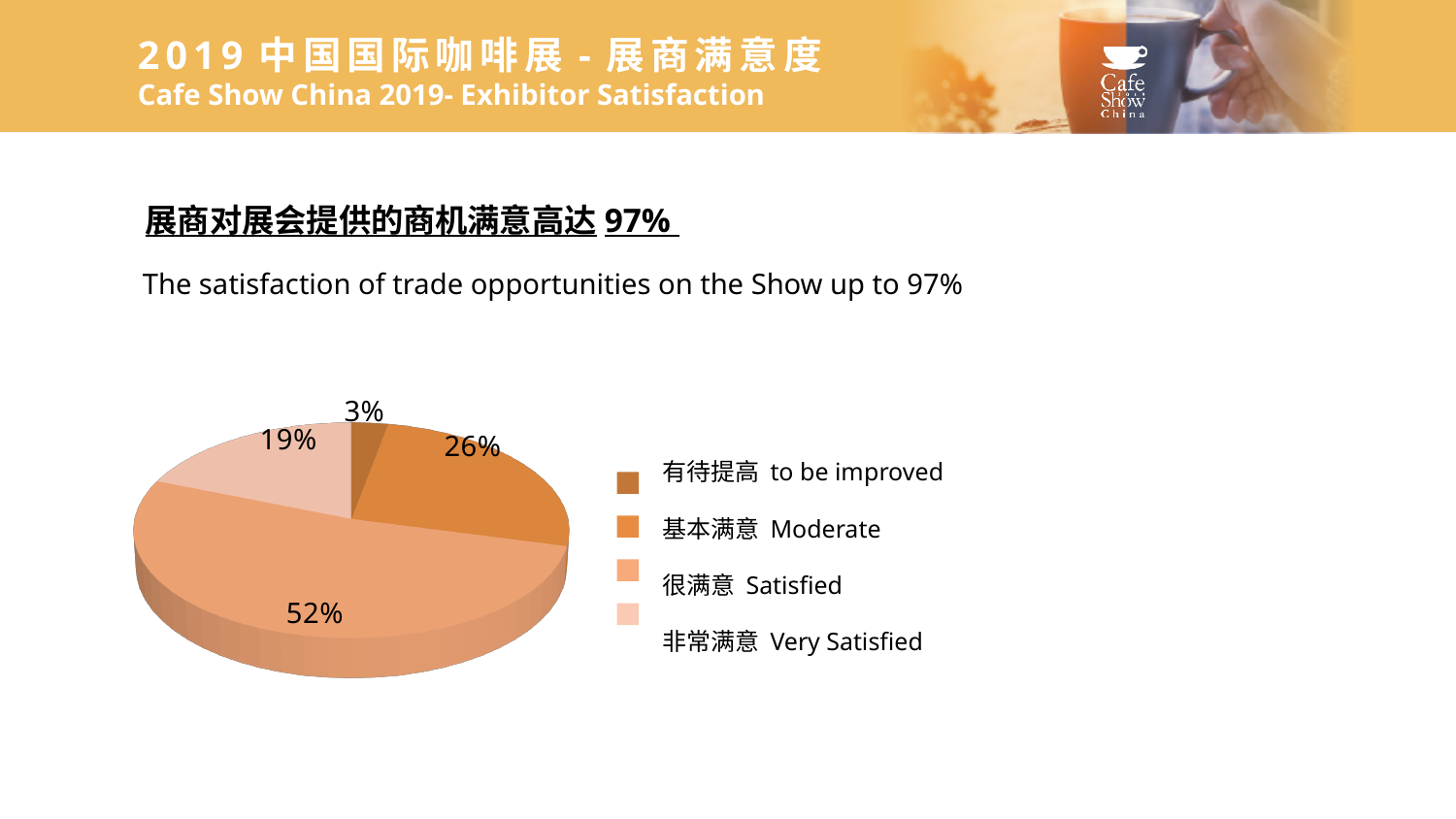
What percentage of exhibitors said trade opportunities were to be improved? 3% What percentage of exhibitors rated trade opportunities as Satisfied? 52% What percentage of exhibitors rated trade opportunities as Very Satisfied? 19% Which category has the smallest share of the pie? To be improved How many entries does the legend list? 4 What percentage of exhibitors rated trade opportunities as Moderate? 26% What kind of chart is shown on the slide? Pie chart How many slices does the pie chart have? 4 Which is larger, the Moderate share or the Very Satisfied share? Moderate Which category has the largest share of the pie? Satisfied What is the difference between the Satisfied share and the Moderate share? 26% What is the combined share of Satisfied and Very Satisfied? 71%